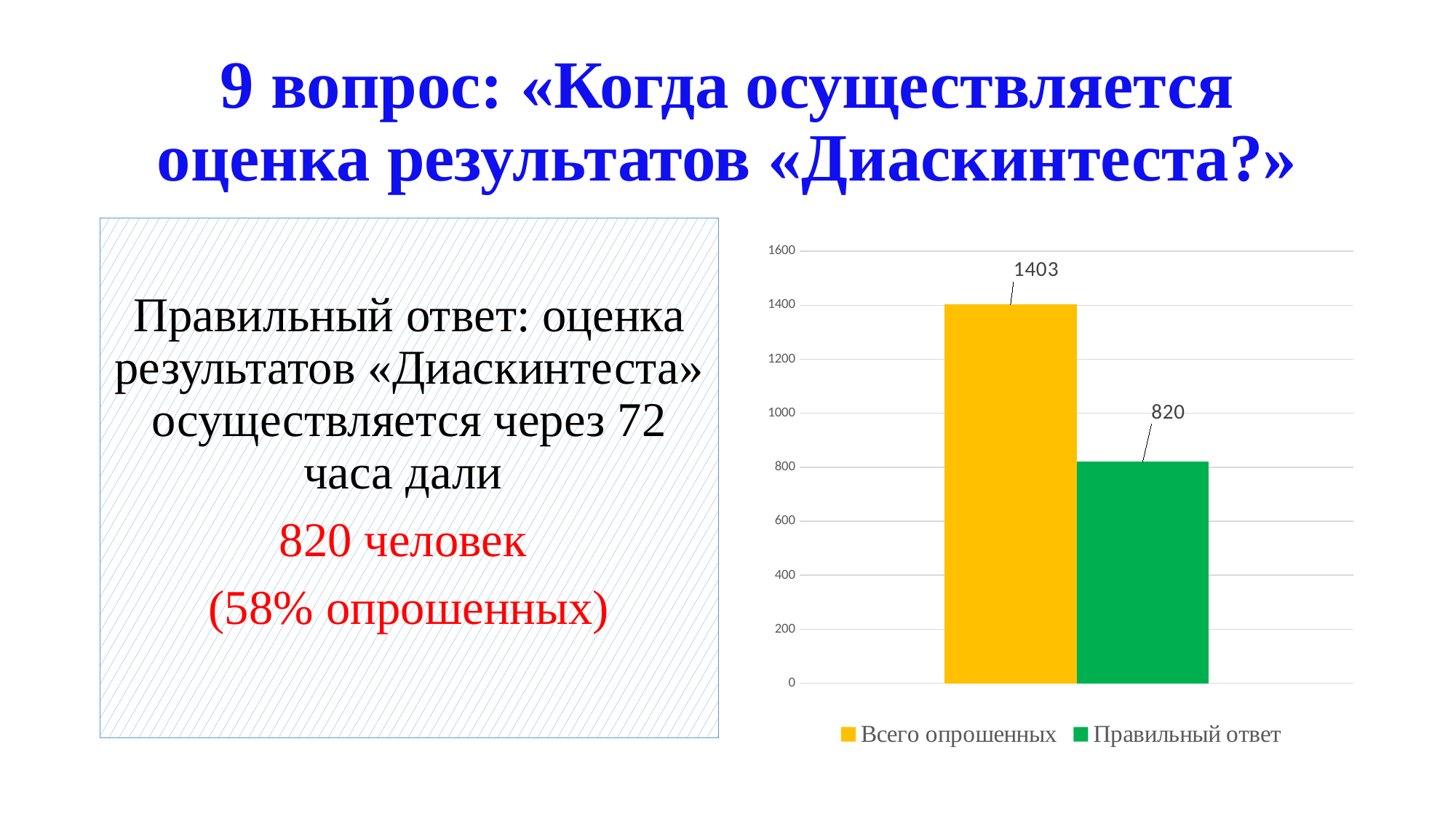
Is the value for Правильный ответ greater or less than 1000? less Which series has the highest value? Всего опрошенных How many bars are plotted on the chart? 2 What is the difference between Всего опрошенных and Правильный ответ? 583 How many series does the legend list? 2 What is the value for Правильный ответ? 820 What colour is the bar for Правильный ответ? green Which series has the lowest value? Правильный ответ Is the value for Всего опрошенных greater or less than 1200? greater What kind of chart is shown on the slide? bar chart What is the value for Всего опрошенных? 1403 Which is larger, Всего опрошенных or Правильный ответ? Всего опрошенных